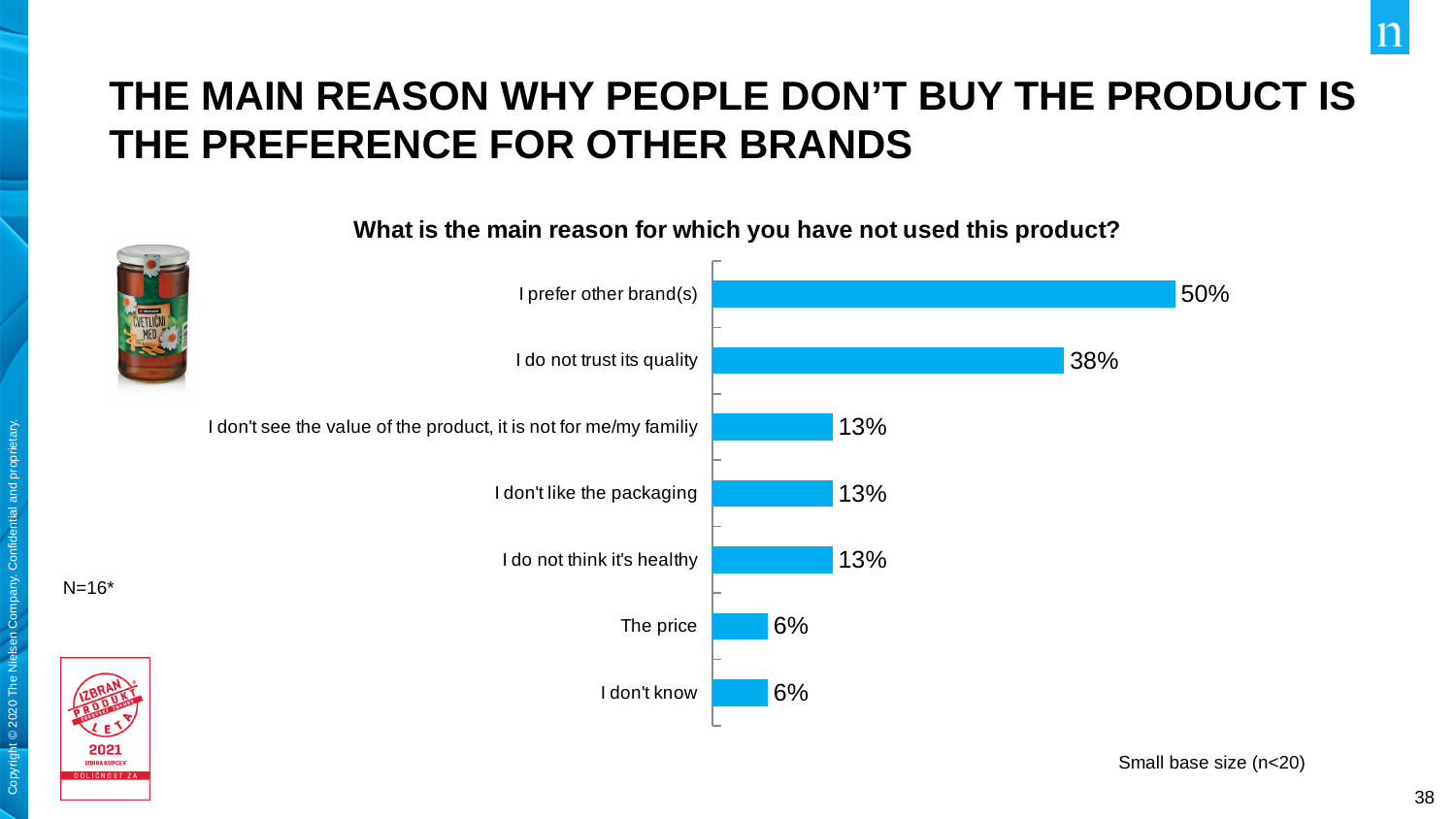
What is the value for 'I do not trust its quality'? 38% How many reasons (categories) are shown in the chart? 7 What percentage of respondents gave 'The price' as the main reason? 6% Which reason has the highest percentage? I prefer other brand(s) What is the difference between 'I prefer other brand(s)' and 'I do not trust its quality'? 12% What is the value for 'I don't like the packaging'? 13% What is the sample size (N) noted on the slide? N=16* What is the question shown as the chart's title? What is the main reason for which you have not used this product? What percentage of respondents said they prefer other brand(s)? 50% Which is larger: 'I do not trust its quality' or 'I do not think it's healthy'? I do not trust its quality What kind of chart is shown on the slide? Bar chart How many categories share the value 13%? 3